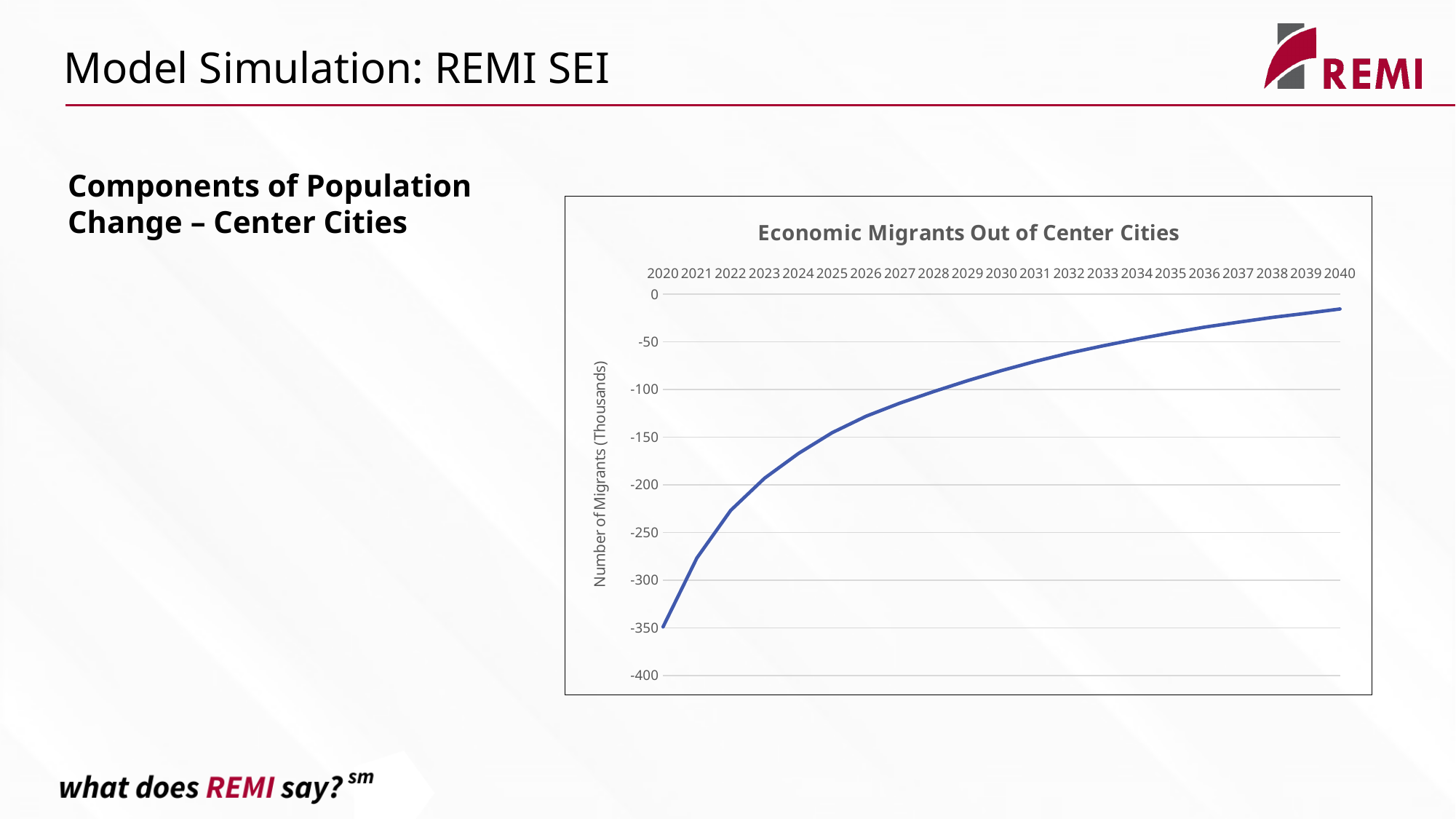
Is the value for 2030 greater or less than -100? greater Is the value for 2020 greater or less than -300? less Which is larger, the value for 2025 or the value for 2035? 2035 Is the value for 2040 greater or less than -50? greater What kind of chart is shown on the slide? line chart What is the label on the vertical axis of the chart? Number of Migrants (Thousands) Which year has the highest value on the chart? 2040 What is the title of the chart? Economic Migrants Out of Center Cities Do the values rise or fall from 2020 to 2040? rise Which year has the lowest value on the chart? 2020 How many years are plotted along the x axis of the chart? 21